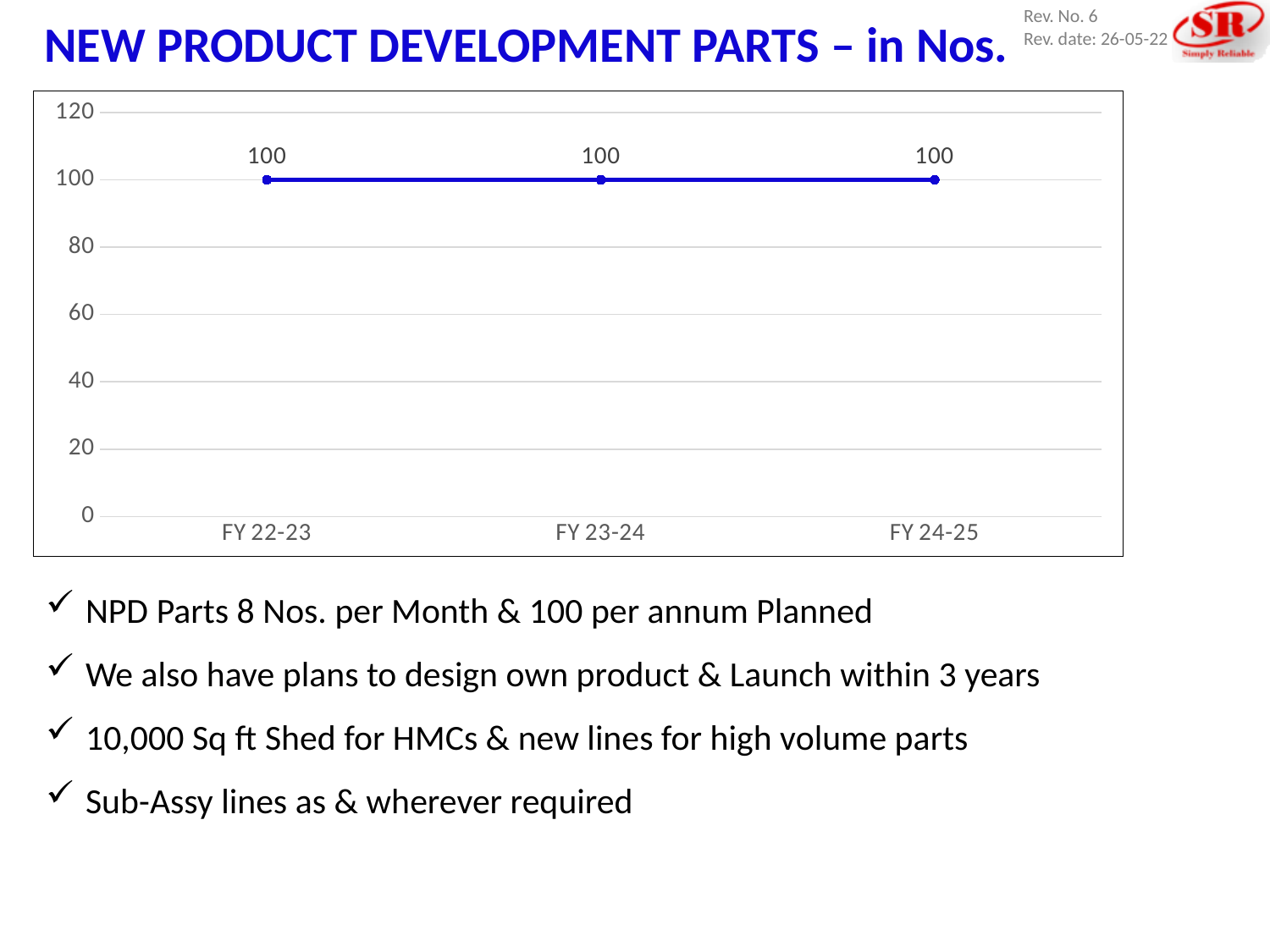
What is the highest value shown on the vertical axis? 120 Do the values rise, fall or stay flat from FY 22-23 to FY 24-25? stay flat What colour is the plotted line? blue How many fiscal years are plotted on the chart? 3 Is the value for FY 23-24 greater or less than 80? greater What kind of chart is shown on the slide? line chart What is the value for FY 24-25? 100 What is the value for FY 22-23? 100 What is the difference between the values for FY 22-23 and FY 24-25? 0 Is the value for FY 24-25 greater or less than 120? less What is the value for FY 23-24? 100